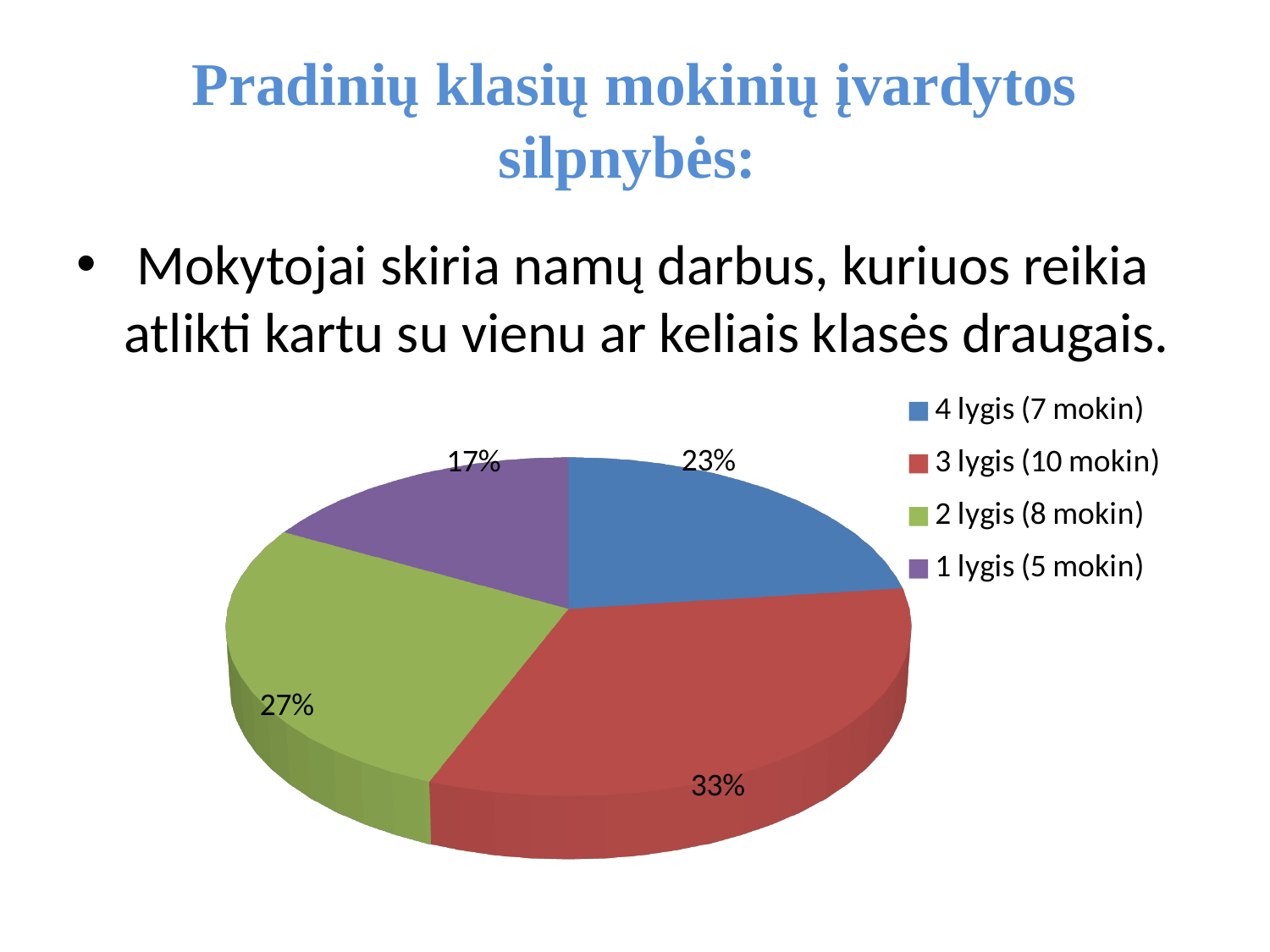
Which category has the smallest slice of the pie? 1 lygis (5 mokin) What share of the pie does the slice for 3 lygis (10 mokin) represent? 33% What share of the pie does the slice for 4 lygis (7 mokin) represent? 23% Which slice is larger: 2 lygis (8 mokin) or 4 lygis (7 mokin)? 2 lygis (8 mokin) Which category has the largest slice of the pie? 3 lygis (10 mokin) What share of the pie does the slice for 2 lygis (8 mokin) represent? 27% What is the difference in percentage points between the slices for 3 lygis (10 mokin) and 1 lygis (5 mokin)? 16 What colour is the slice for 3 lygis (10 mokin)? red How many slices does the pie chart have? 4 How many entries does the legend list? 4 What kind of chart is shown on the slide? pie chart